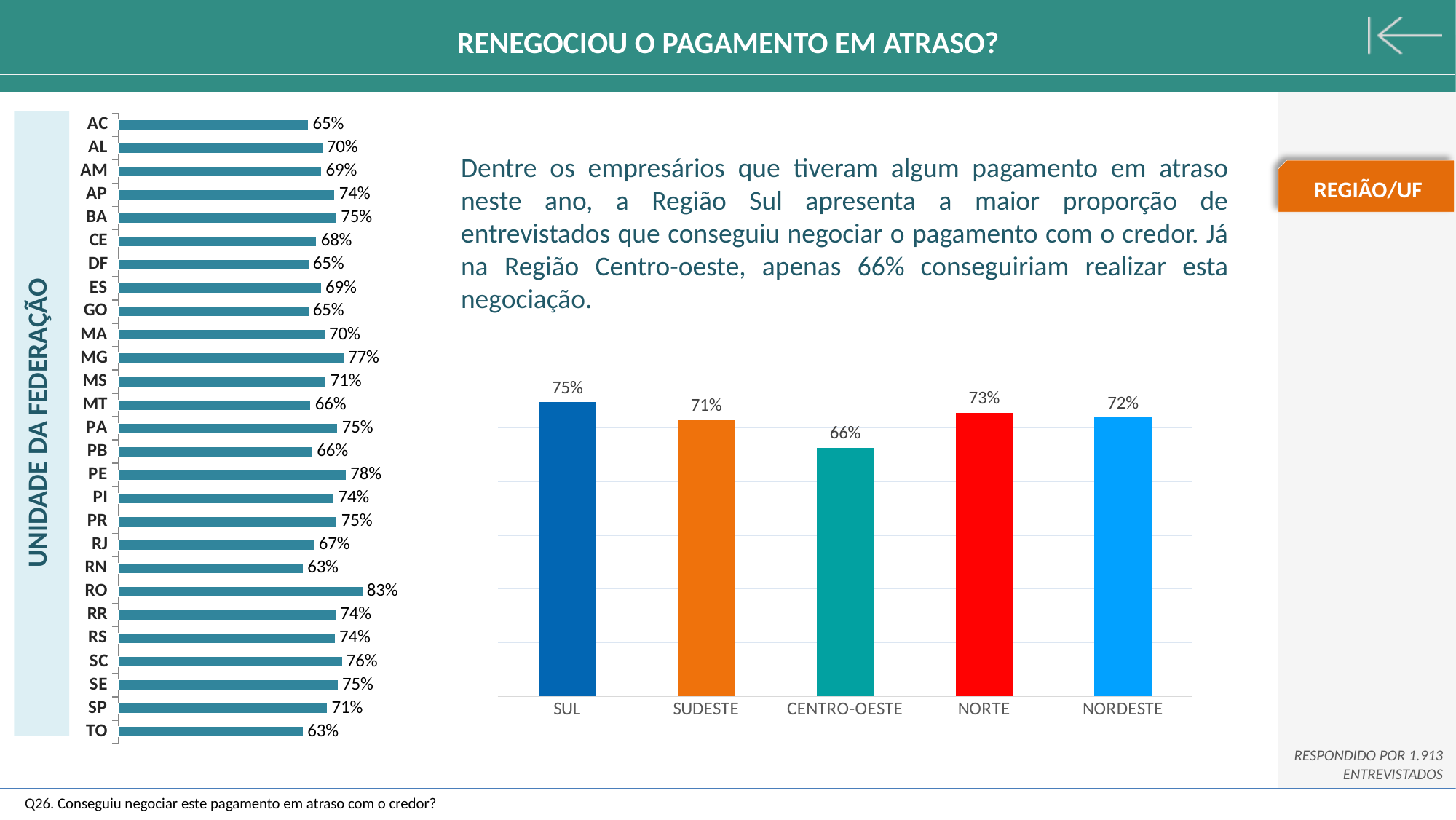
In the right chart by region, which region has the lowest value? CENTRO-OESTE In the left chart by unidade da federação, what is the value for RO? 83% What kind of chart is the right chart by region? Bar chart In the right chart by region, how many regions are shown? 5 In the left chart by unidade da federação, which is larger, the value for MG or the value for SP? MG In the right chart by region, what is the difference between the values for SUL and SUDESTE? 4% In the right chart by region, what is the value for CENTRO-OESTE? 66% In the left chart by unidade da federação, which state has the highest value? RO In the left chart by unidade da federação, what is the difference between the values for RO and TO? 20% In the left chart by unidade da federação, what is the value for PE? 78% In the left chart by unidade da federação, how many states are listed? 27 In the right chart by region, which region has the highest value? SUL